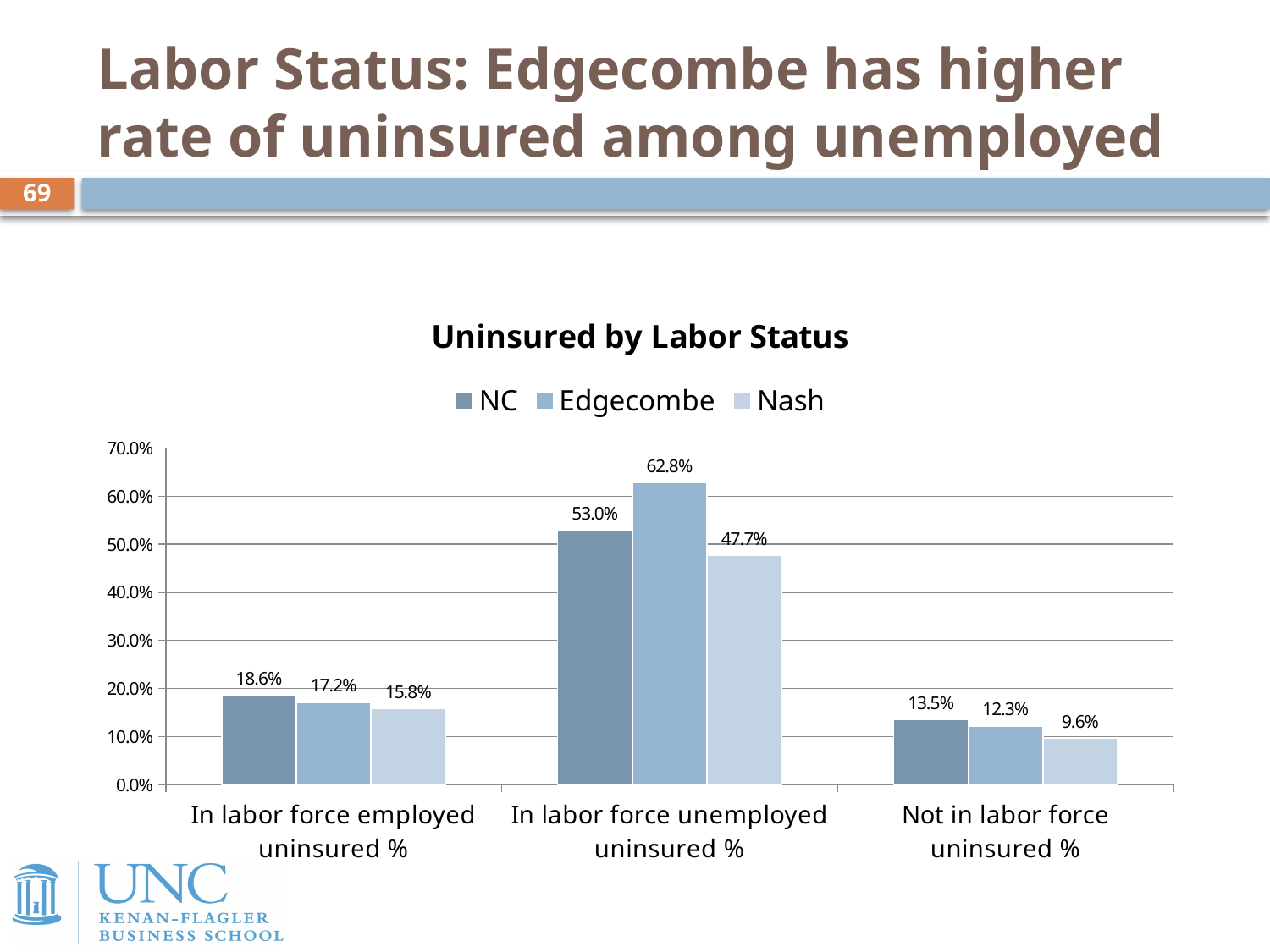
What kind of chart is shown on the slide? bar chart Is the Nash value for In labor force unemployed uninsured % greater or less than 40.0%? greater What is the NC value for In labor force employed uninsured %? 18.6% What is the difference between the Edgecombe and NC values for In labor force unemployed uninsured %? 9.8% How many series does the legend list? 3 What is the Edgecombe value for In labor force unemployed uninsured %? 62.8% How many categories are shown on the x axis? 3 Which series has the highest value for In labor force unemployed uninsured %? Edgecombe Which is larger for Not in labor force uninsured %: the NC value or the Edgecombe value? NC What is the Nash value for Not in labor force uninsured %? 9.6% Which category has the lowest Nash value? Not in labor force uninsured % What is the title of the chart? Uninsured by Labor Status